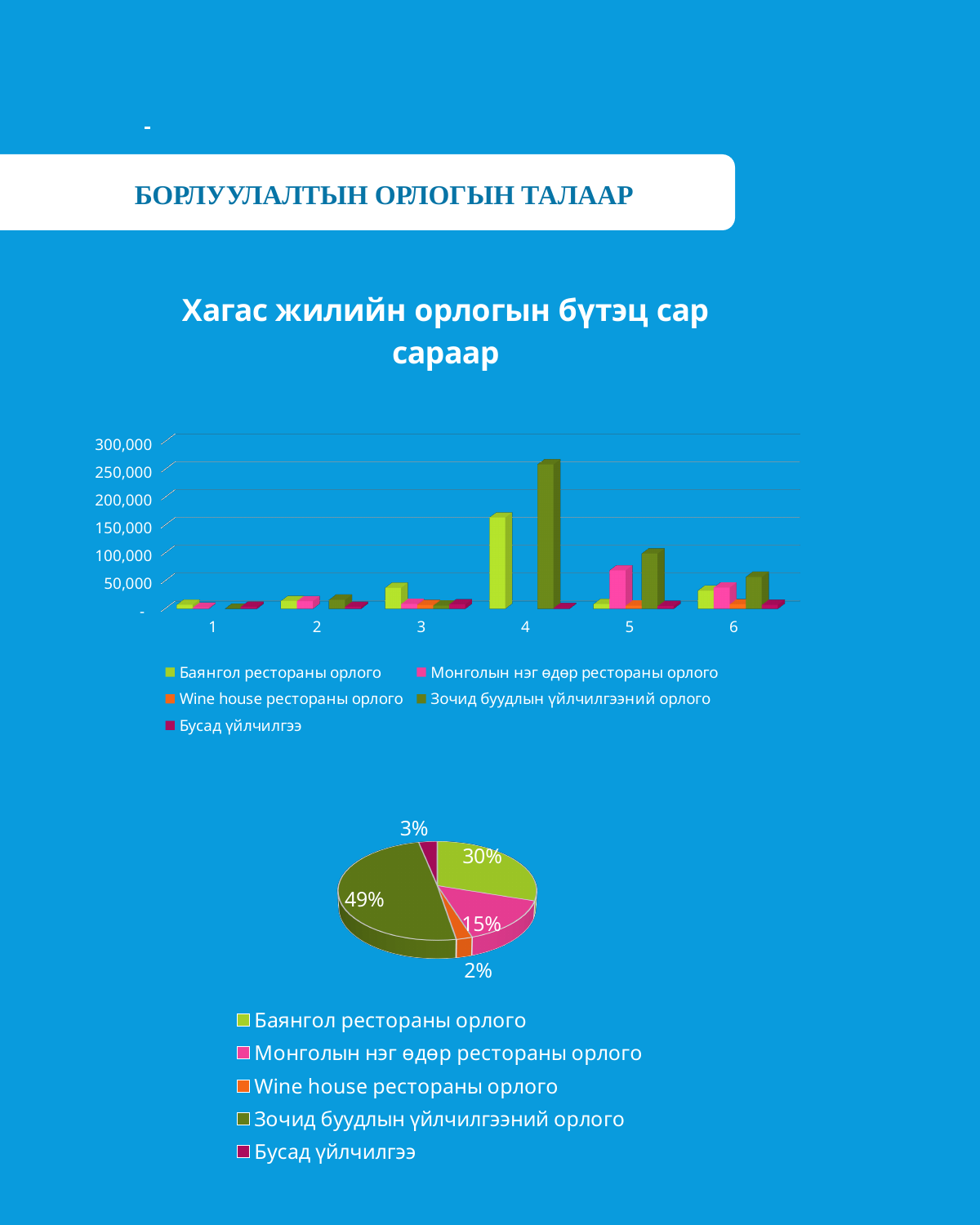
In the bottom pie chart, what is the difference in percentage points between Баянгол рестораны орлого and Монголын нэг өдөр рестораны орлого? 15 In the bottom pie chart, which slice is the smallest? Wine house рестораны орлого In the top bar chart, is the value for Зочид буудлын үйлчилгээний орлого in month 4 greater or less than 200,000? greater In the bottom pie chart, what share does Зочид буудлын үйлчилгээний орлого have? 49% In the top bar chart, how many series does the legend list? 5 What kind of chart is the bottom chart on the slide? Pie chart In the top bar chart, in which month is the Зочид буудлын үйлчилгээний орлого bar highest? 4 What kind of chart is the top chart titled "Хагас жилийн орлогын бүтэц сар сараар"? Bar chart In the top bar chart, is the value for Баянгол рестораны орлого in month 4 greater or less than 100,000? greater In the top bar chart, in month 5, which is larger: Зочид буудлын үйлчилгээний орлого or Монголын нэг өдөр рестораны орлого? Зочид буудлын үйлчилгээний орлого In the bottom pie chart, what share does Баянгол рестораны орлого have? 30% In the top bar chart, how many categories are shown on the x axis? 6